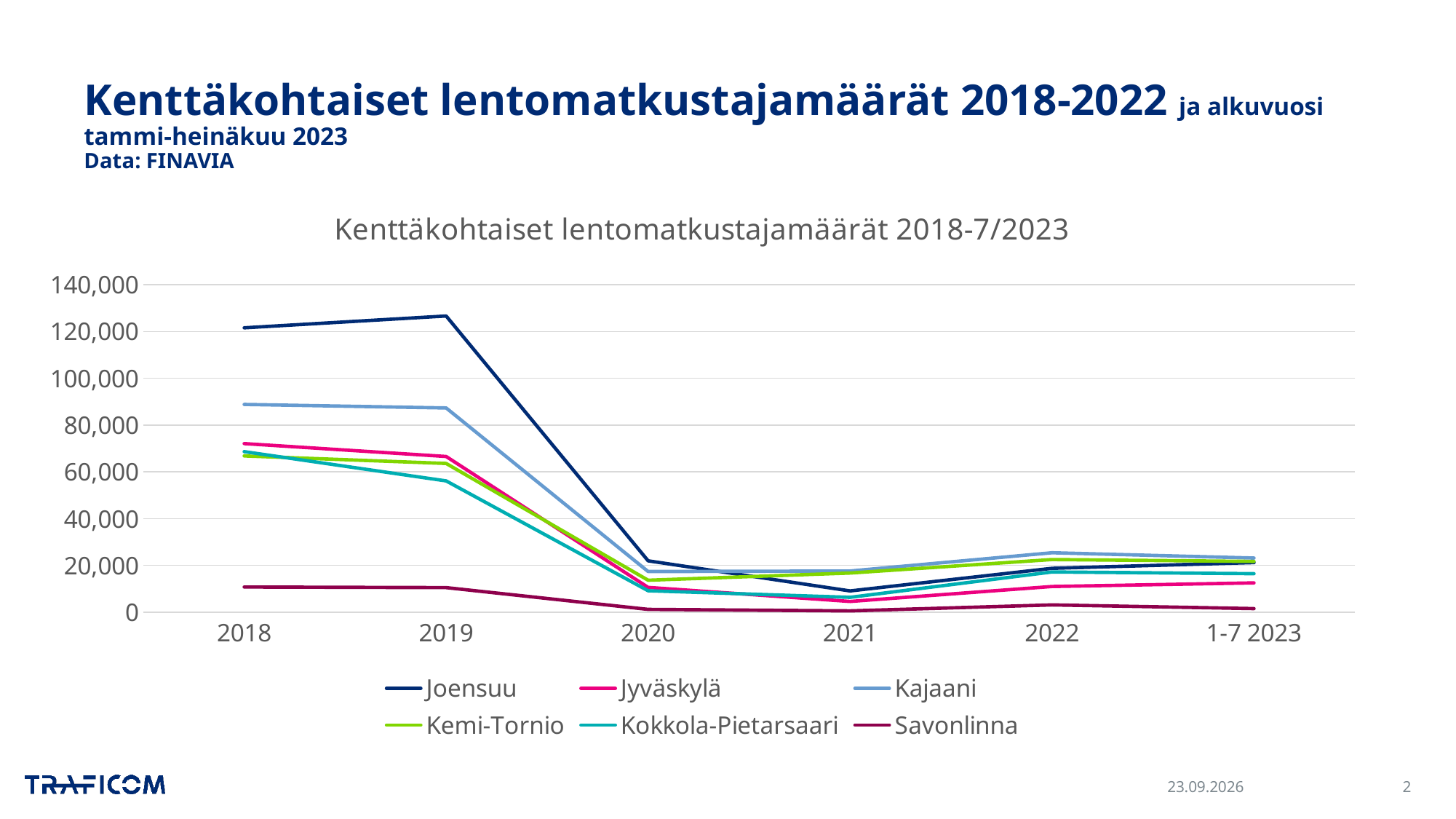
Which series has the highest value in 2018? Joensuu Which is larger in 2019, the value for Joensuu or the value for Kajaani? Joensuu Which series has the lowest value in 2019? Savonlinna Is the value for Kajaani in 2018 greater or less than 80,000? greater Does the value for Joensuu rise or fall from 2019 to 2020? fall Is the value for Joensuu in 2019 greater or less than 120,000? greater How many points are there along the x axis? 6 Is the value for Joensuu in 2021 greater or less than 20,000? less What kind of chart is shown on the slide? line chart How many series does the legend list? 6 What is the title of the chart? Kenttäkohtaiset lentomatkustajamäärät 2018-7/2023